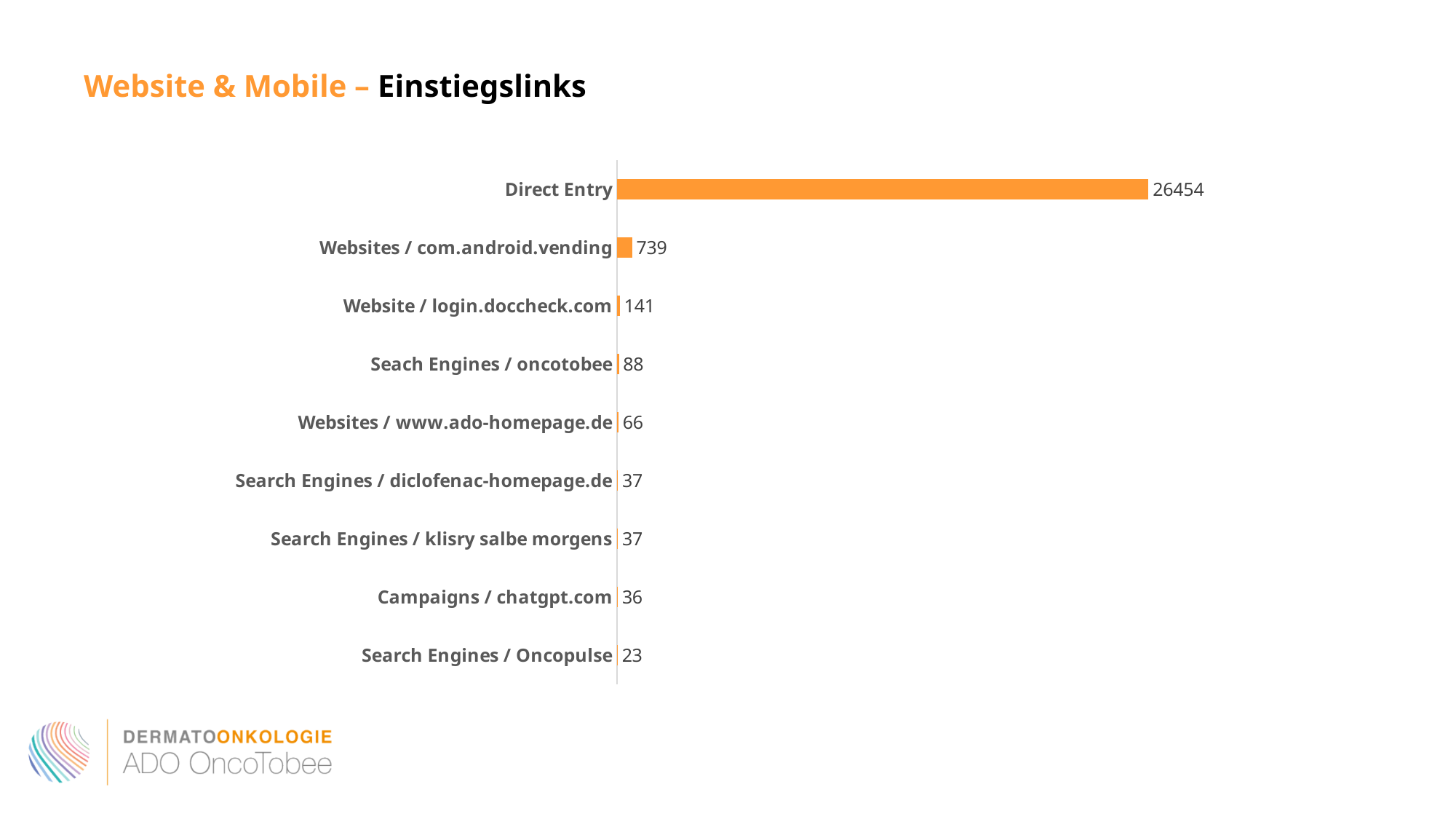
What kind of chart is shown on the slide? Bar chart What is the difference between Seach Engines / oncotobee and Websites / www.ado-homepage.de? 22 What is the difference between Direct Entry and Websites / com.android.vending? 25715 Which is larger, Website / login.doccheck.com or Seach Engines / oncotobee? Website / login.doccheck.com What colour are the bars in the chart? Orange Which category has the lowest value? Search Engines / Oncopulse What is the value for Campaigns / chatgpt.com? 36 What is the value for Direct Entry? 26454 Which category has the highest value? Direct Entry What is the value for Website / login.doccheck.com? 141 What is the value for Websites / com.android.vending? 739 How many categories are shown in the chart? 9